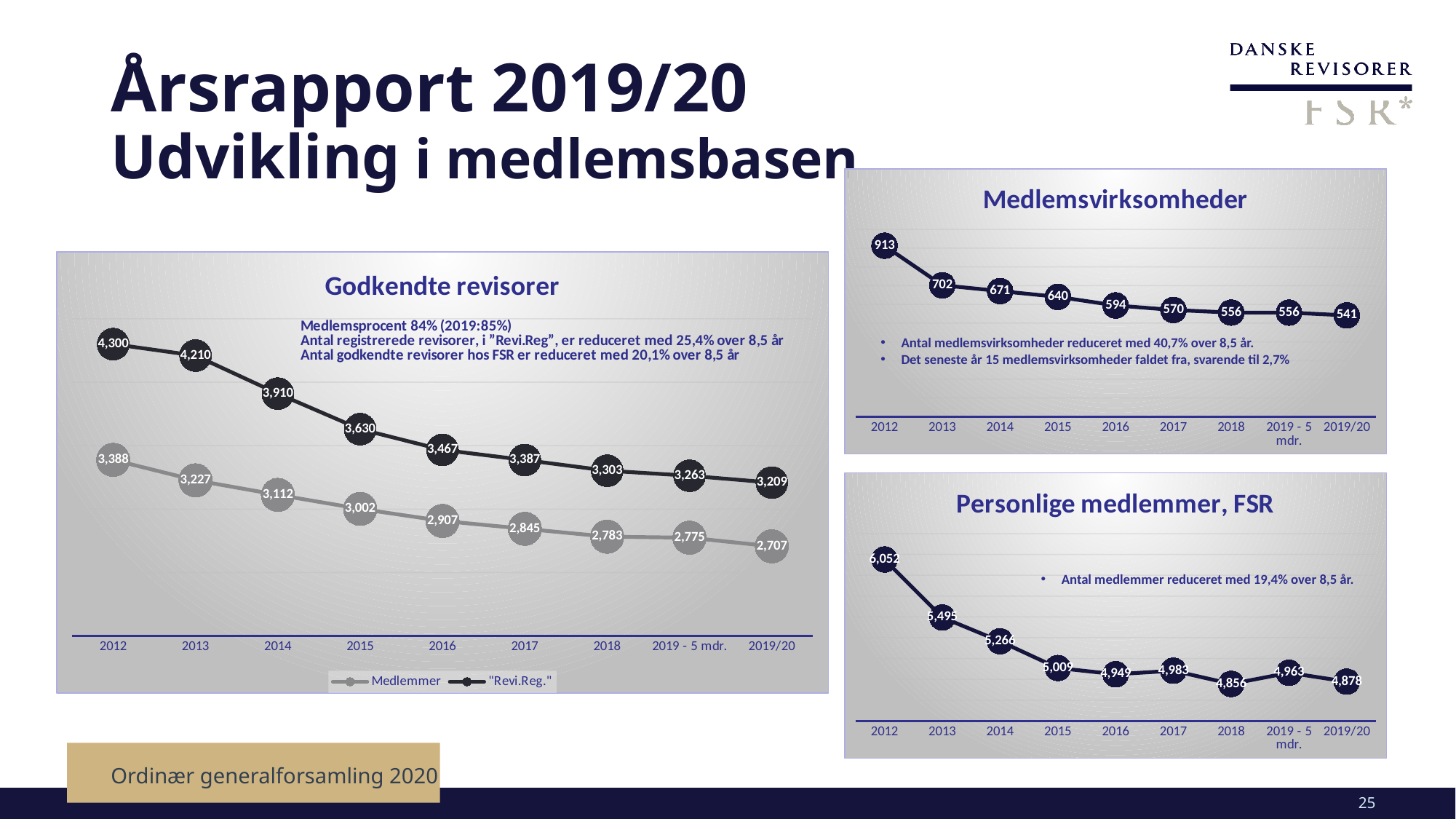
In the "Personlige medlemmer, FSR" chart, what is the value for 2015? 5,009 In the "Godkendte revisorer" chart, what is the difference between the "Revi.Reg." and Medlemmer values for 2016? 560 In the "Godkendte revisorer" chart, what is the Medlemmer value for 2019/20? 2,707 In the "Medlemsvirksomheder" chart, what is the difference between the 2012 and 2013 values? 211 In the "Medlemsvirksomheder" chart, what is the value for 2012? 913 In the "Personlige medlemmer, FSR" chart, which is larger, the value for 2017 or the value for 2018? 2017 In the "Medlemsvirksomheder" chart, how many data points are plotted? 9 In the "Godkendte revisorer" chart, what is the "Revi.Reg." value for 2012? 4,300 What type of chart is the "Personlige medlemmer, FSR" chart? line chart In the "Godkendte revisorer" chart, do the Medlemmer values rise or fall from 2012 to 2019/20? fall In the "Godkendte revisorer" chart, how many series does the legend list? 2 In the "Medlemsvirksomheder" chart, which year has the lowest value? 2019/20